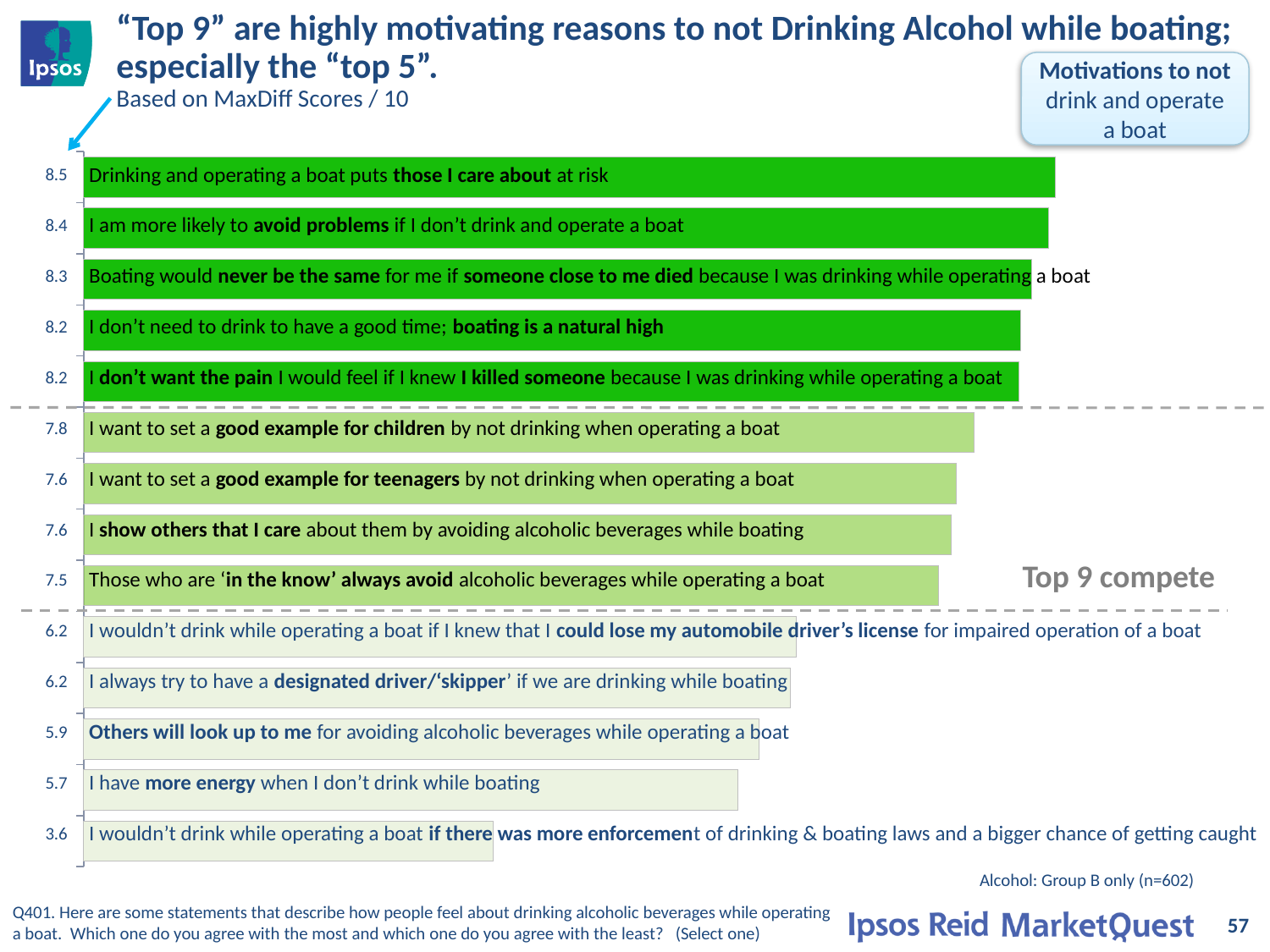
What is the MaxDiff score for "I want to set a good example for children by not drinking when operating a boat"? 7.8 What type of chart is used on this slide? Bar chart Which has a higher MaxDiff score: "I don't need to drink to have a good time; boating is a natural high" or "I always try to have a designated driver/'skipper' if we are drinking while boating"? I don't need to drink to have a good time; boating is a natural high What is the MaxDiff score for "Drinking and operating a boat puts those I care about at risk"? 8.5 What is the difference in MaxDiff score between "I am more likely to avoid problems if I don't drink and operate a boat" and "Others will look up to me for avoiding alcoholic beverages while operating a boat"? 2.5 What is the MaxDiff score for "I have more energy when I don't drink while boating"? 5.7 What is the difference between the highest MaxDiff score (8.5) and the lowest (3.6)? 4.9 What scale are the MaxDiff scores based on, according to the subtitle? MaxDiff Scores / 10 Which statement has the highest MaxDiff score? Drinking and operating a boat puts those I care about at risk How many statements (bars) are shown in the chart? 14 Do the MaxDiff scores rise or fall going from the top bar to the bottom bar? Fall Which statement has the lowest MaxDiff score? I wouldn't drink while operating a boat if there was more enforcement of drinking & boating laws and a bigger chance of getting caught